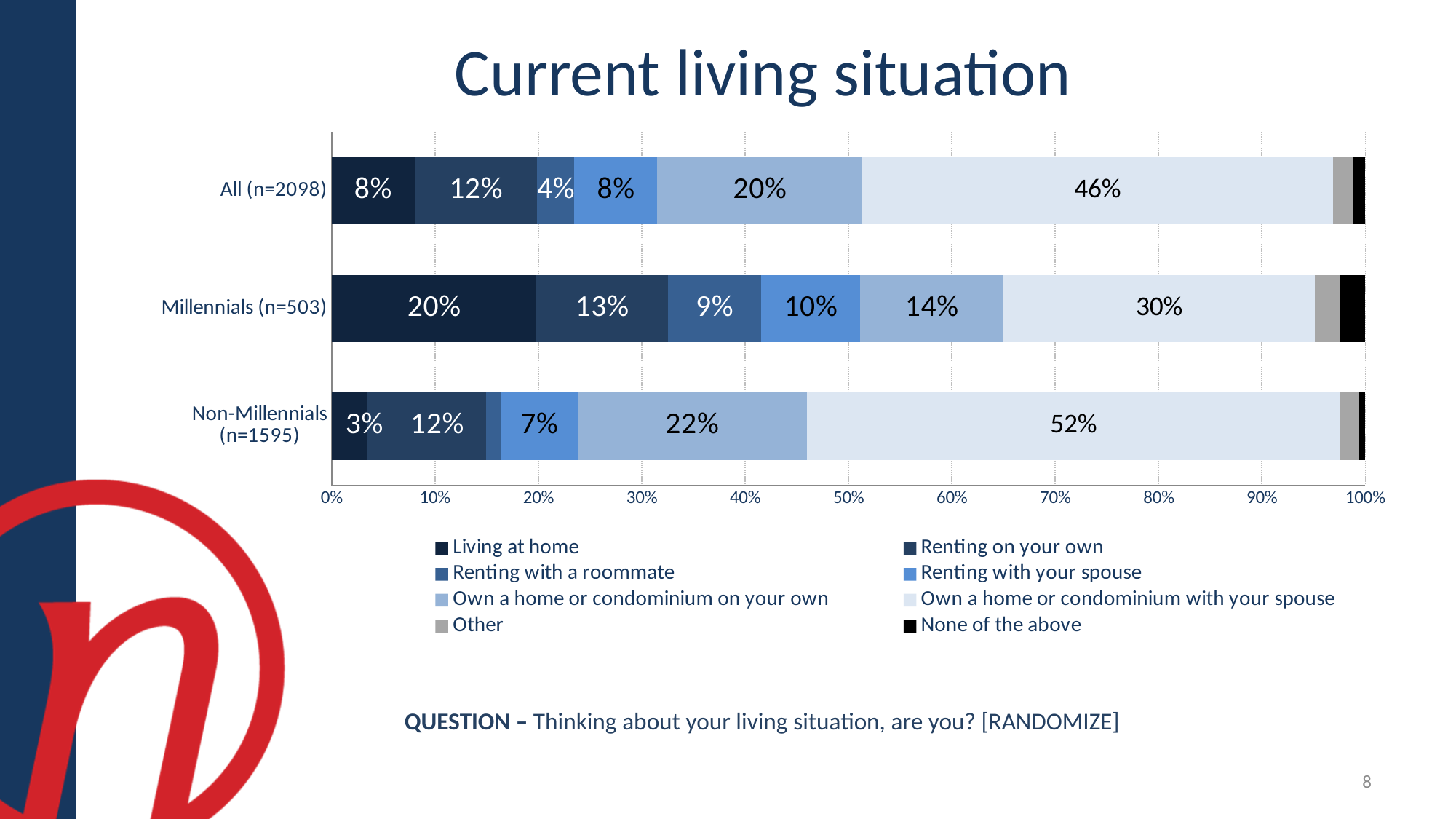
What percentage of Millennials (n=503) are living at home? 20% What is the difference in percentage points between Non-Millennials and Millennials for owning a home or condominium with your spouse? 22 percentage points What percentage of Non-Millennials (n=1595) own a home or condominium on their own? 22% Which group has the lowest share owning a home or condominium with their spouse? Millennials (n=503) Which group has the highest share living at home? Millennials (n=503) Which is larger: the share renting with a roommate among All respondents or among Millennials? Millennials What is the title of the chart? Current living situation What kind of chart is shown on the slide? Stacked bar chart What percentage of All respondents (n=2098) own a home or condominium with their spouse? 46% How many series does the legend list? 8 What percentage of Millennials (n=503) are renting with a roommate? 9% How many respondent groups are shown on the chart? 3